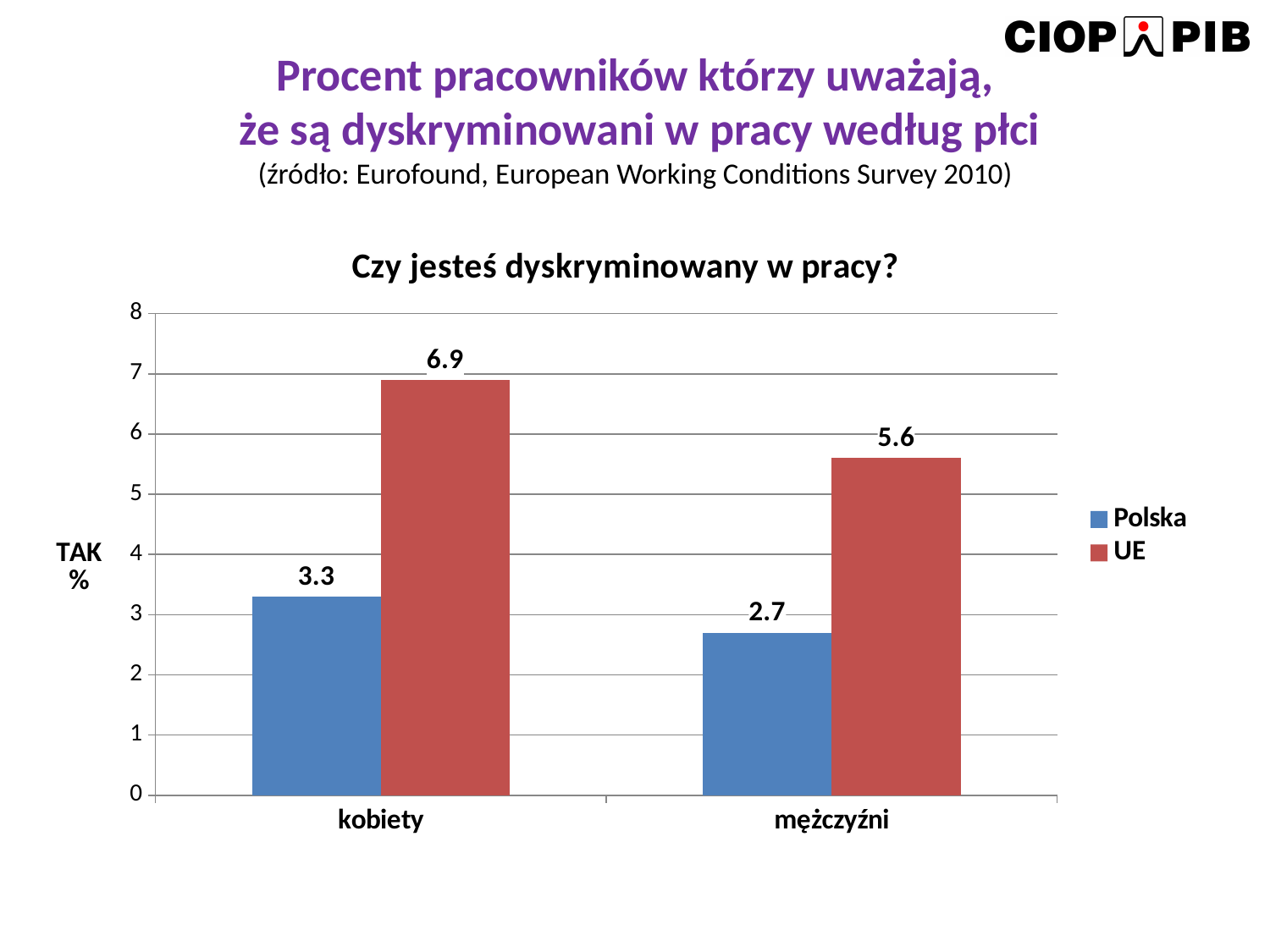
What is the value for UE in the kobiety category? 6.9 Which bar has the highest value on the chart? UE, kobiety What is the title of the chart? Czy jesteś dyskryminowany w pracy? How many series does the legend list? 2 What is the value for Polska in the kobiety category? 3.3 What is the value for UE in the mężczyźni category? 5.6 Which is larger: the Polska value for kobiety or the Polska value for mężczyźni? kobiety What is the difference between the UE values for kobiety and mężczyźni? 1.3 What is the value for Polska in the mężczyźni category? 2.7 What is the difference between the UE and Polska values for kobiety? 3.6 What kind of chart is shown on the slide? bar chart Which bar has the lowest value on the chart? Polska, mężczyźni